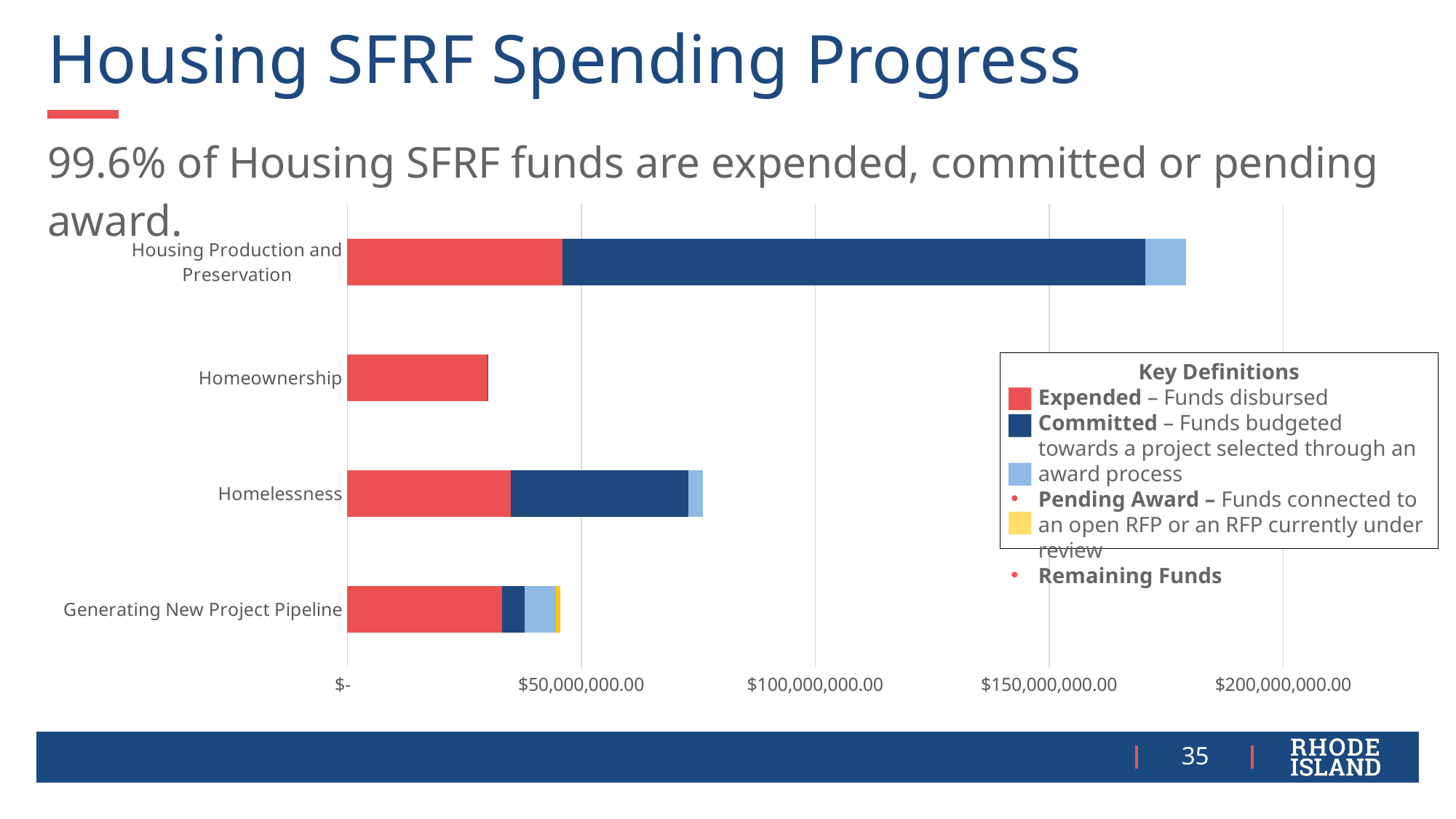
Is the total value for Homelessness greater or less than $100,000,000.00? less Is the total value for Homeownership greater or less than $50,000,000.00? less Is the total value for Housing Production and Preservation greater or less than $150,000,000.00? greater What kind of chart is shown on the slide? Stacked bar chart How many entries does the Key Definitions legend list? 4 Which category has the smallest total bar? Homeownership How many categories are plotted on the chart? 4 Which colour represents Expended in the legend? Red Which has a larger total bar, Housing Production and Preservation or Homelessness? Housing Production and Preservation Which category has the largest total bar? Housing Production and Preservation Which has a larger total bar, Homelessness or Homeownership? Homelessness